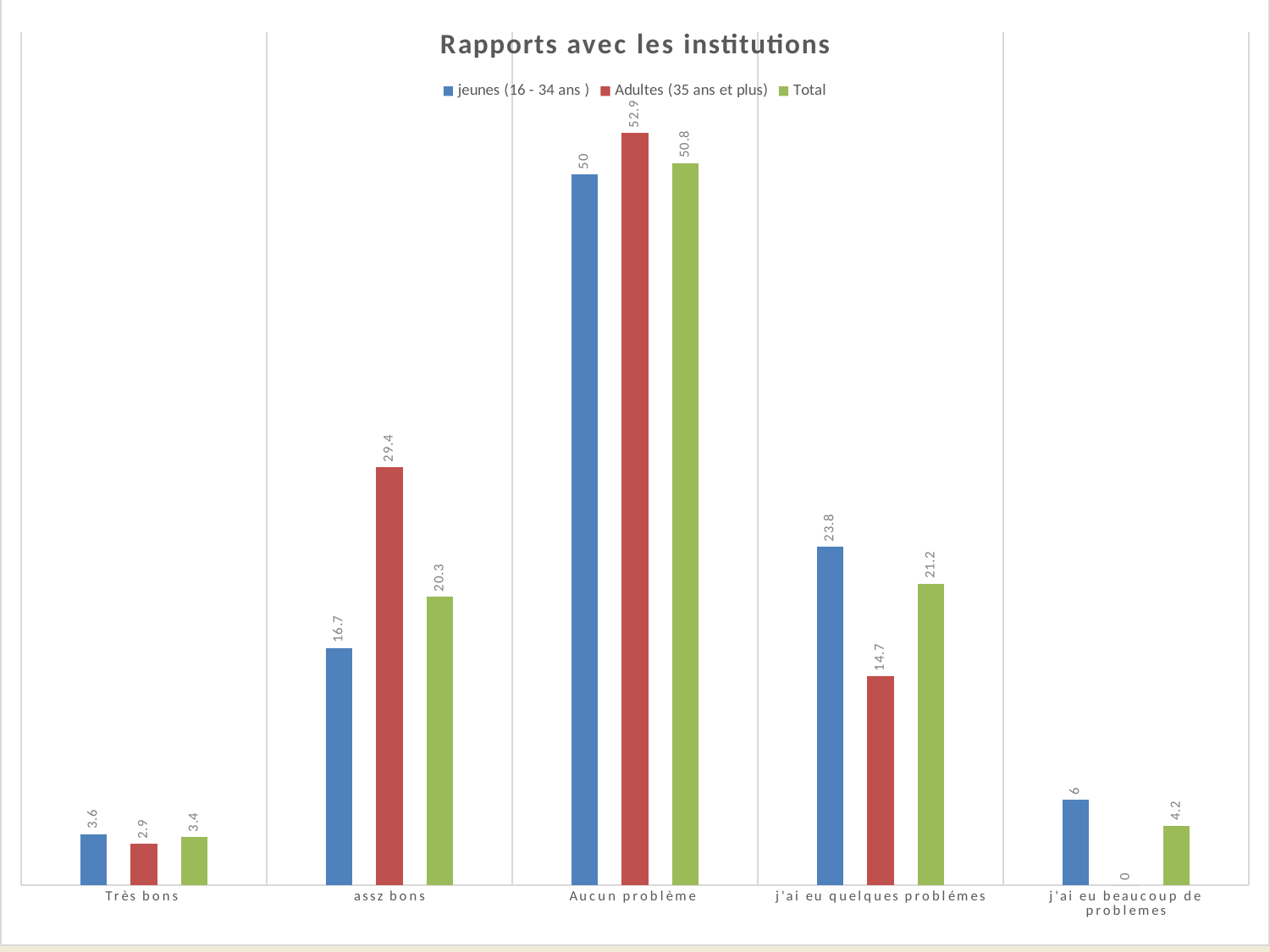
What is the value for 'Adultes (35 ans et plus)' in the 'j'ai eu beaucoup de problemes' category? 0 What kind of chart is shown on the slide? Bar chart How many series does the legend list? 3 What is the 'Total' value for 'j'ai eu quelques problémes'? 21.2 What is the value for 'jeunes (16 - 34 ans )' in the 'Aucun problème' category? 50 How many categories are shown on the x axis? 5 What is the value for 'Adultes (35 ans et plus)' in the 'assz bons' category? 29.4 Which category has the highest value for the 'Total' series? Aucun problème In the 'j'ai eu quelques problémes' category, which is larger: the value for 'jeunes (16 - 34 ans )' or for 'Adultes (35 ans et plus)'? jeunes (16 - 34 ans ) What is the difference between the 'Adultes (35 ans et plus)' and 'jeunes (16 - 34 ans )' values in the 'assz bons' category? 12.7 What is the title of the chart? Rapports avec les institutions Which category has the lowest value for the 'jeunes (16 - 34 ans )' series? Très bons